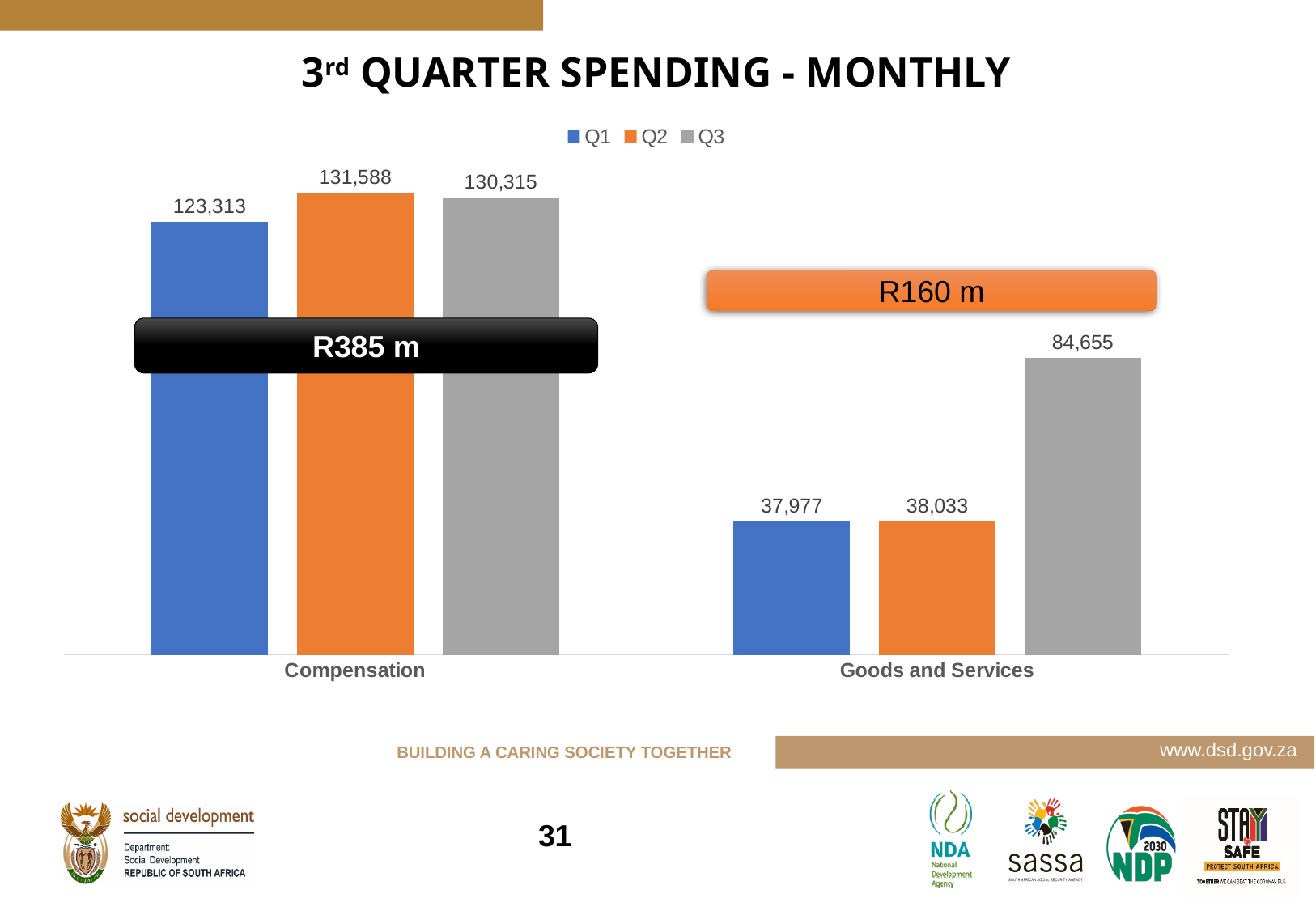
What is the Q2 value for Goods and Services? 38,033 What is the Q3 value for Goods and Services? 84,655 What is the Q1 value for Compensation? 123,313 How many categories are shown on the x axis? 2 How many series does the legend list? 3 What kind of chart is shown on the slide? Bar chart What total amount is shown in the black label over the Compensation bars? R385 m What is the difference between the Q2 and Q1 values for Compensation? 8,275 Which quarter has the highest value for Compensation? Q2 Which bar has the lowest value on the chart? Q1 for Goods and Services (37,977) Which is larger, the Q3 value for Compensation or the Q3 value for Goods and Services? Compensation What is the difference between the Q3 and Q1 values for Goods and Services? 46,678